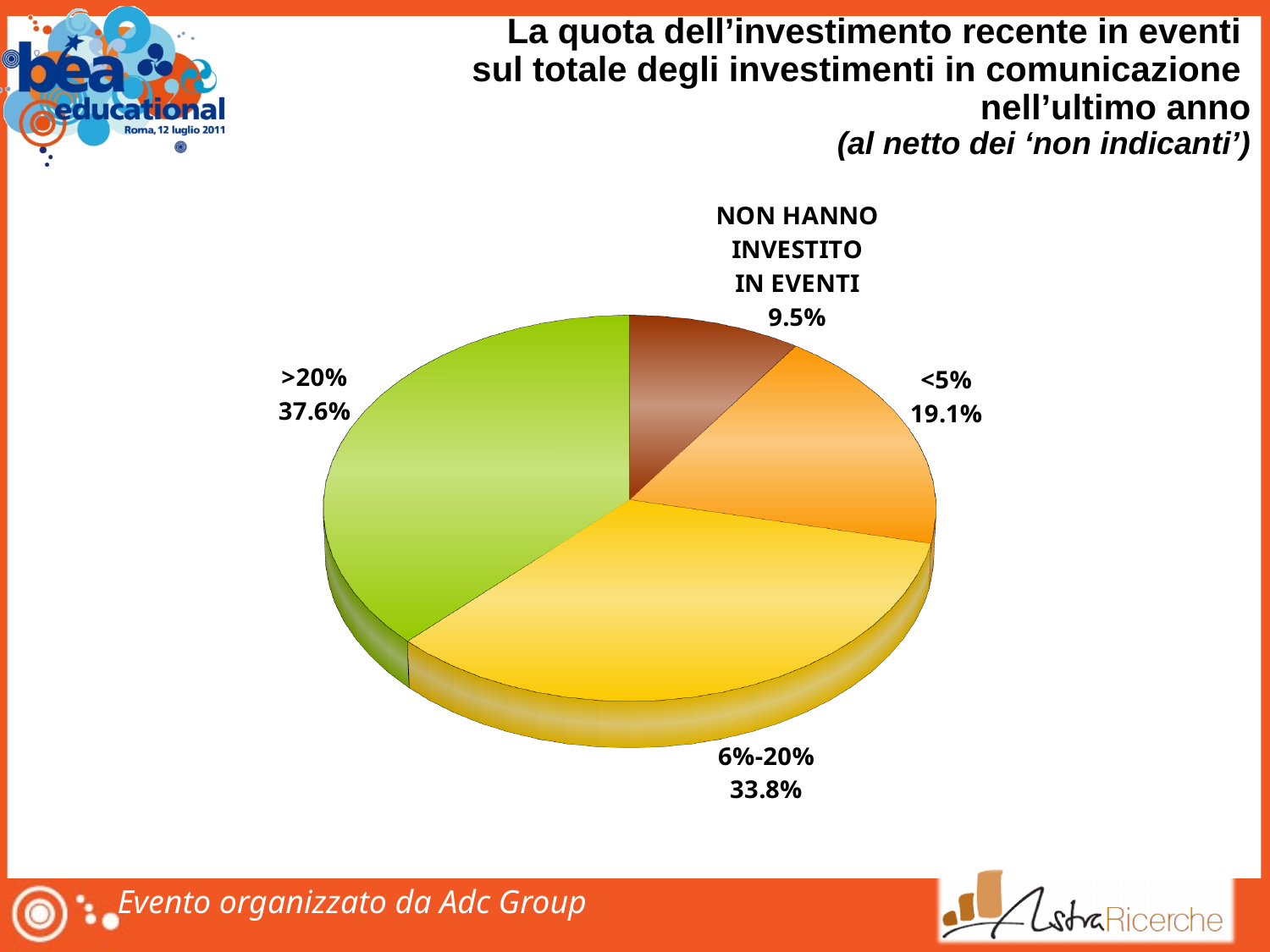
How many slices does the pie chart have? 4 What share of the pie does the '>20%' slice represent? 37.6% What share of the pie does the '<5%' slice represent? 19.1% Which is larger, the '<5%' slice or the '6%-20%' slice? 6%-20% Which slice of the pie is the largest? >20% What share of the pie does the '6%-20%' slice represent? 33.8% What kind of chart is shown on the slide? pie chart Which slice of the pie is the smallest? NON HANNO INVESTITO IN EVENTI What is the difference between the '>20%' slice and the '6%-20%' slice? 3.8% What colour is the '>20%' slice of the pie? green What is the difference between the '<5%' slice and the 'NON HANNO INVESTITO IN EVENTI' slice? 9.6% What share of the pie does the 'NON HANNO INVESTITO IN EVENTI' slice represent? 9.5%